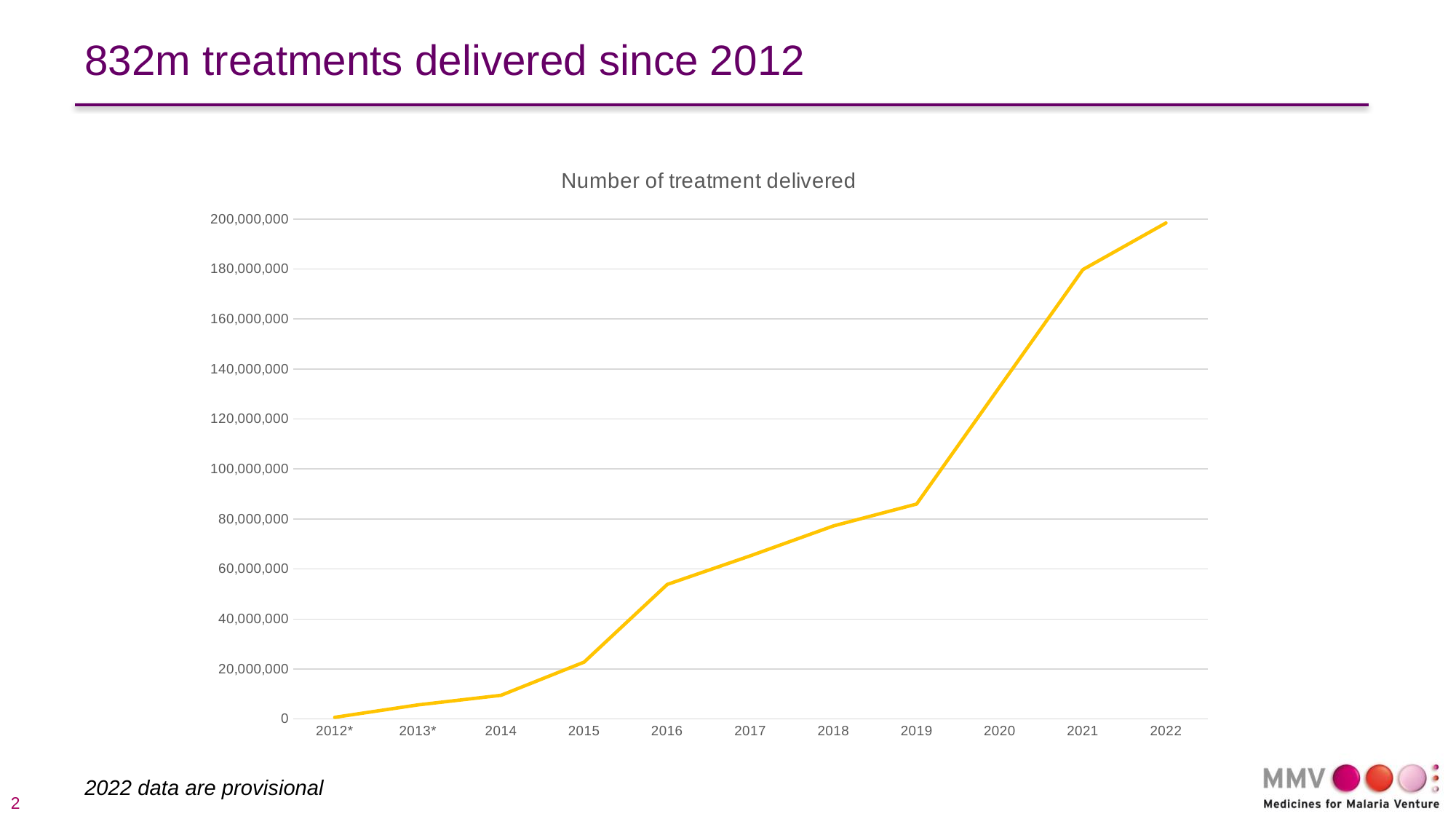
How many years are plotted on the x axis of the chart? 11 Do the values rise or fall from 2012* to 2022? rise Which year has the larger value, 2019 or 2020? 2020 What is the title of the chart? Number of treatment delivered Is the value for 2016 greater or less than 40,000,000? greater Which year has the lowest number of treatments delivered? 2012* Which year has the highest number of treatments delivered? 2022 Is the value for 2021 greater or less than 160,000,000? greater Is the value for 2014 greater or less than 20,000,000? less What kind of chart is shown on the slide? line chart